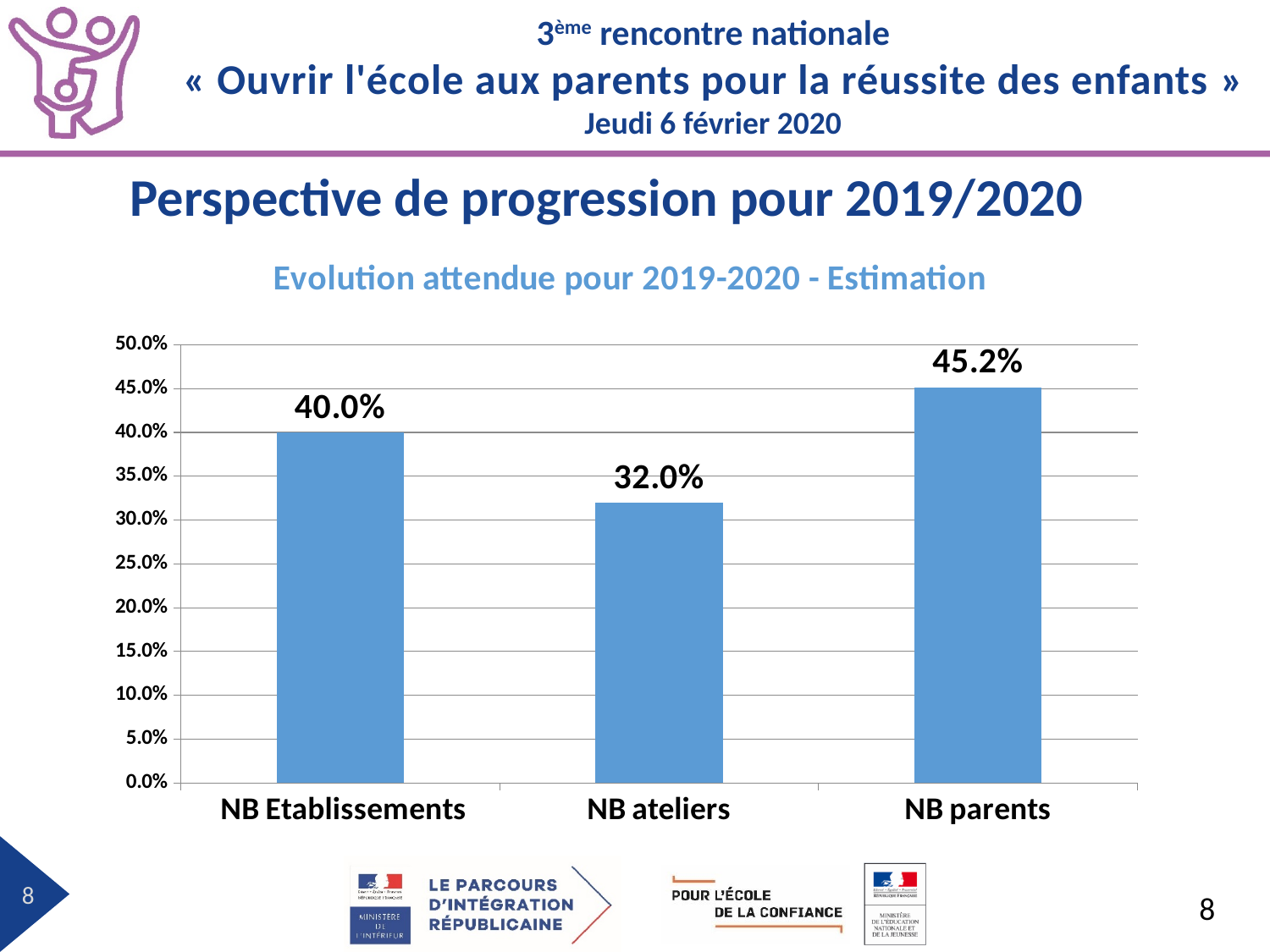
What is the difference between the values for NB parents and NB Etablissements? 5.2% What is the title of the chart? Evolution attendue pour 2019-2020 - Estimation Which category has the highest value? NB parents What kind of chart is shown on the slide? bar chart Is the value for NB ateliers greater or less than 35.0%? less Which category has the lowest value? NB ateliers Which is larger, the value for NB ateliers or the value for NB parents? NB parents How many categories are shown on the x axis? 3 What is the difference between the values for NB Etablissements and NB ateliers? 8.0% What is the value for NB ateliers? 32.0% What is the value for NB parents? 45.2% What is the value for NB Etablissements? 40.0%